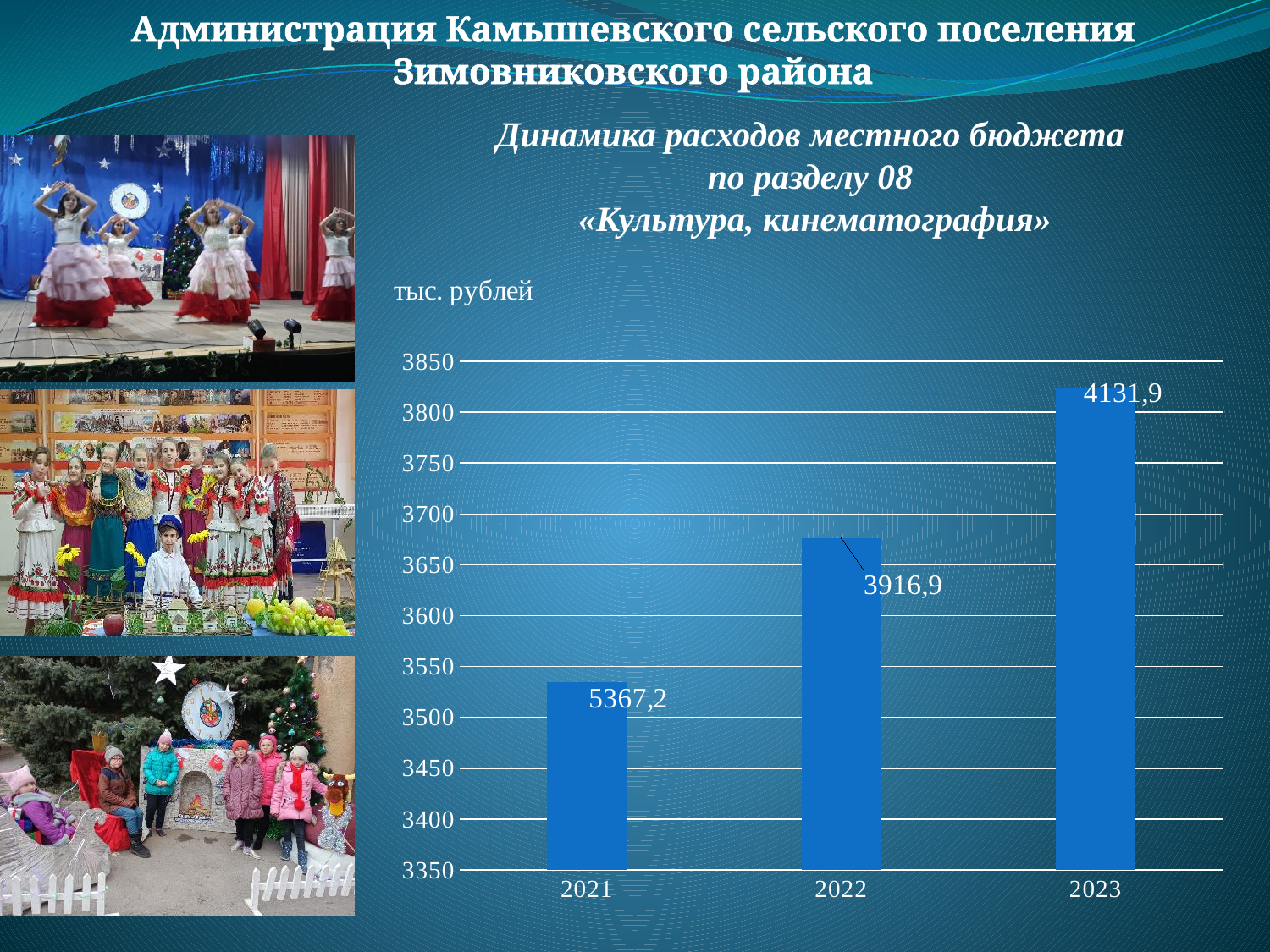
What kind of chart is shown on the slide? bar chart Is the bar for 2021 greater or less than 3500 on the axis? greater What value is labelled on the bar for 2021? 5367,2 Is the bar for 2023 greater or less than 3800 on the axis? greater Which budget section (раздел) does the chart title say the expenditures relate to? 08 «Культура, кинематография» What is the difference between the labelled values for 2023 and 2022? 215 What is the difference between the labelled values for 2021 and 2022? 1450,3 Is the bar for 2022 greater or less than 3650 on the axis? greater What value is labelled on the bar for 2022? 3916,9 What unit of measurement is stated above the chart? тыс. рублей What value is labelled on the bar for 2023? 4131,9 How many years are shown on the x axis of the chart? 3